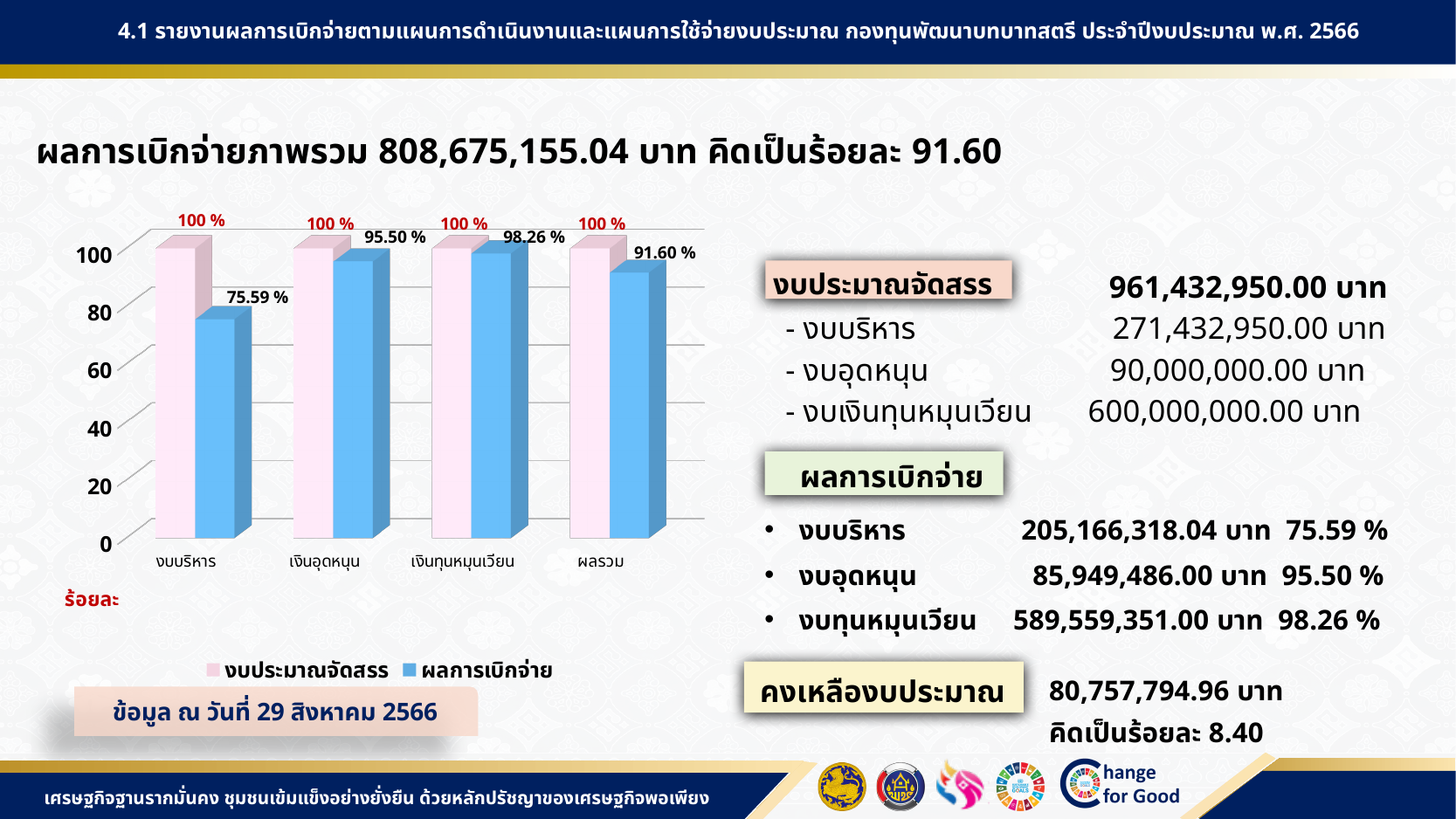
Which category has the lowest ผลการเบิกจ่าย value? งบบริหาร Which category has the highest ผลการเบิกจ่าย value? เงินทุนหมุนเวียน What is the value of ผลการเบิกจ่าย for เงินอุดหนุน? 95.50 % What is the value of ผลการเบิกจ่าย for งบบริหาร? 75.59 % How many categories are shown on the x axis of the chart? 4 How many series does the chart legend list? 2 Which is larger, the ผลการเบิกจ่าย value for เงินอุดหนุน or for ผลรวม? เงินอุดหนุน What kind of chart is shown on the slide? Bar chart What is the value of ผลการเบิกจ่าย for ผลรวม? 91.60 % What is the value of ผลการเบิกจ่าย for เงินทุนหมุนเวียน? 98.26 % What is the difference between the ผลการเบิกจ่าย values for เงินทุนหมุนเวียน and งบบริหาร? 22.67 % What is the value of งบประมาณจัดสรร for เงินอุดหนุน? 100 %